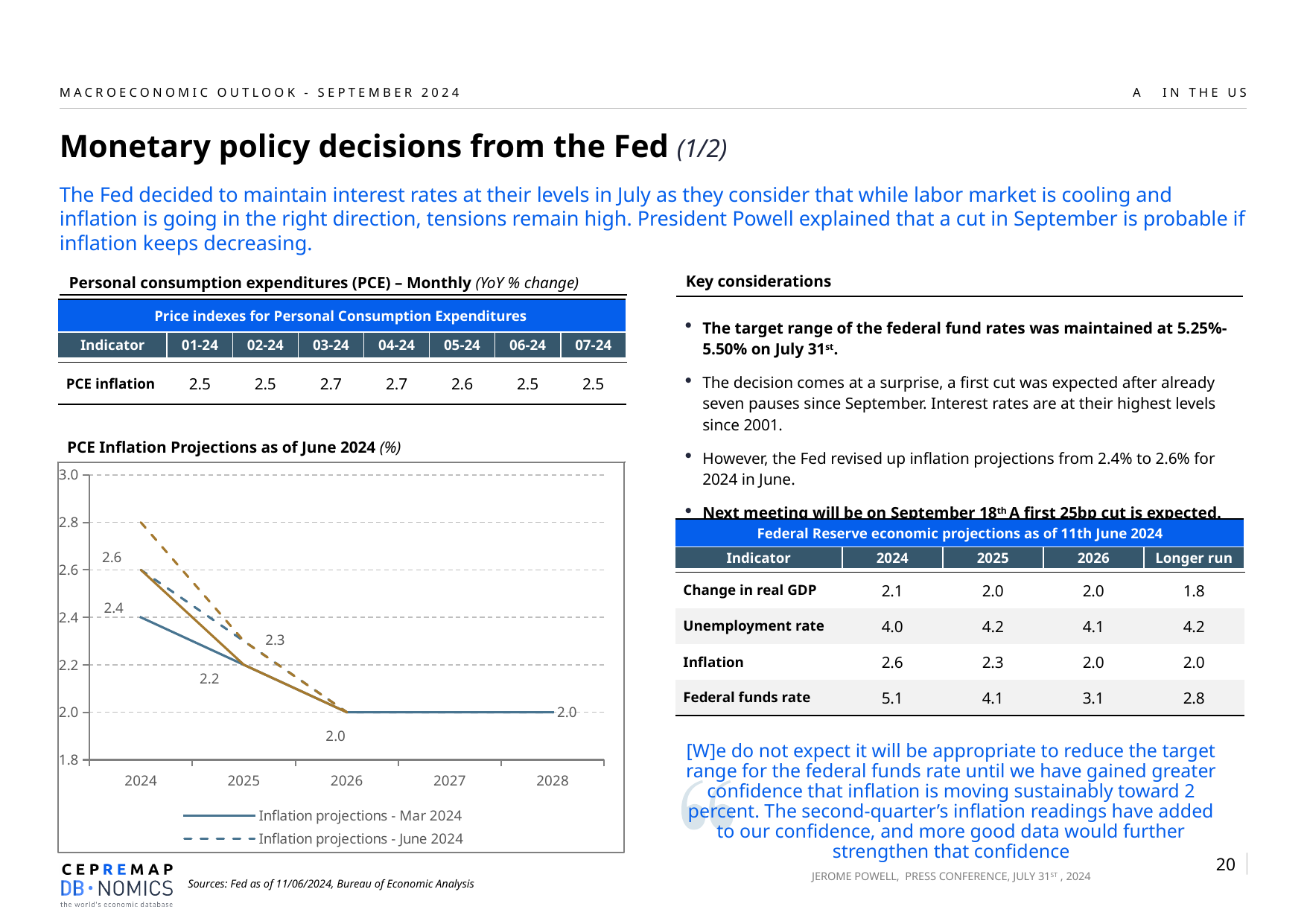
In the PCE Inflation Projections chart, what is the difference between the June 2024 and Mar 2024 projections for 2024? 0.2 In the PCE Inflation Projections chart, what is the June 2024 inflation projection for 2025? 2.3 How many years are shown on the x axis of the PCE Inflation Projections chart? 5 In the PCE Inflation Projections chart, do the projections rise or fall from 2024 to 2026? fall In the PCE Inflation Projections chart, what is the Mar 2024 inflation projection for 2025? 2.2 In the PCE Inflation Projections chart, what value is labelled for 2026? 2.0 What kind of chart is the 'PCE Inflation Projections as of June 2024' chart? line chart How many series does the legend of the PCE Inflation Projections chart list? 2 In the PCE Inflation Projections chart, what is the June 2024 inflation projection for 2024? 2.6 In the PCE Inflation Projections chart, what is the Mar 2024 inflation projection for 2024? 2.4 In the PCE Inflation Projections chart, what value is labelled for 2028? 2.0 In the PCE Inflation Projections chart, which series shows the higher projection for 2025, Mar 2024 or June 2024? Inflation projections - June 2024